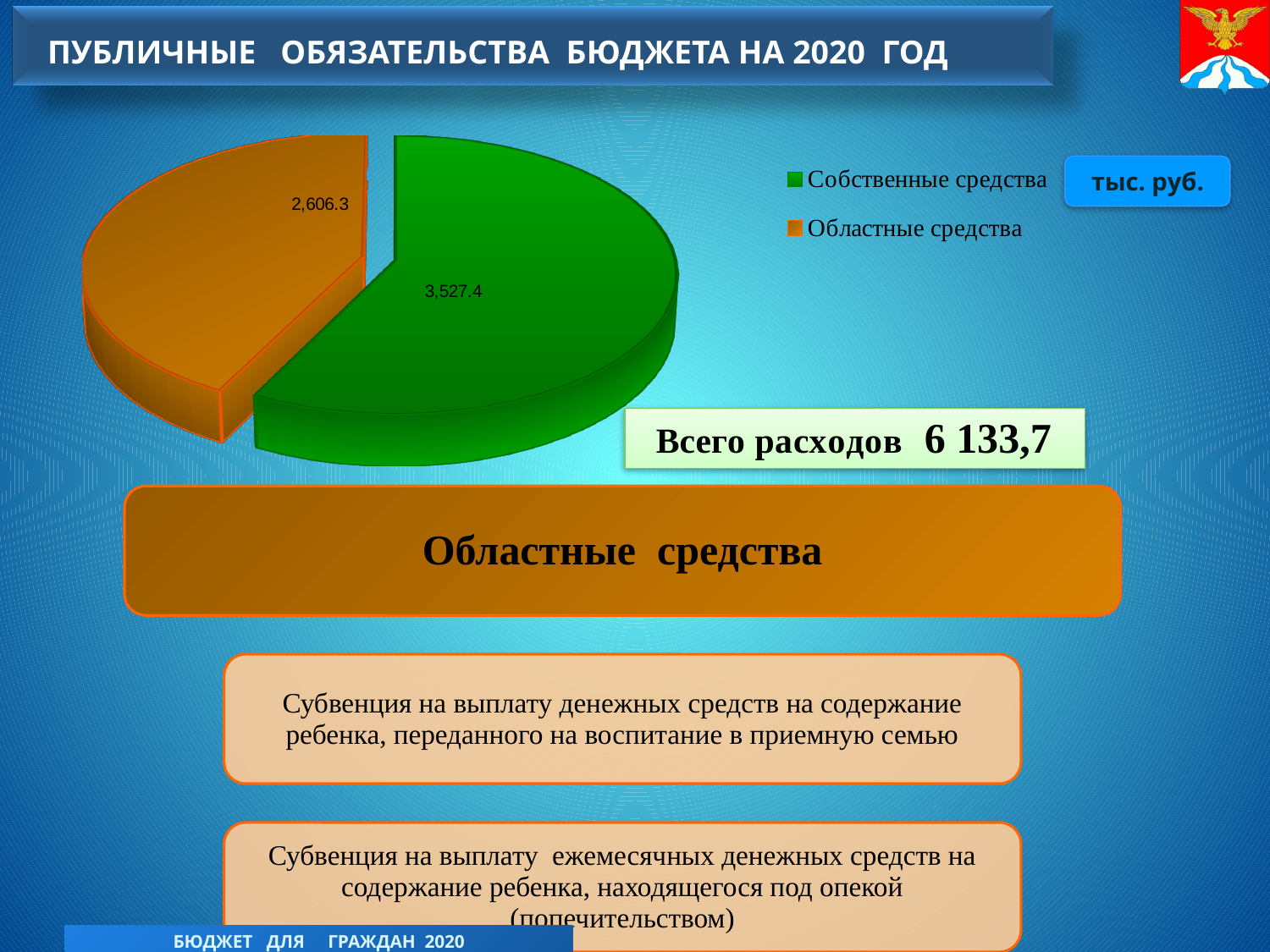
What is the value for Областные средства in the pie chart? 2,606.3 What is the value for Собственные средства in the pie chart? 3,527.4 What type of chart is shown on the slide? Pie chart What share of the pie chart does Областные средства represent? 42.5% What is the difference between the values for Собственные средства and Областные средства in the pie chart? 921.1 Which is larger in the pie chart: Собственные средства or Областные средства? Собственные средства How many slices does the pie chart have? 2 Which slice of the pie chart is the smallest? Областные средства What colour is the Областные средства slice in the pie chart? Orange Which slice of the pie chart is the largest? Собственные средства What is the total of the two slices in the pie chart? 6,133.7 What share of the pie chart does Собственные средства represent? 57.5%